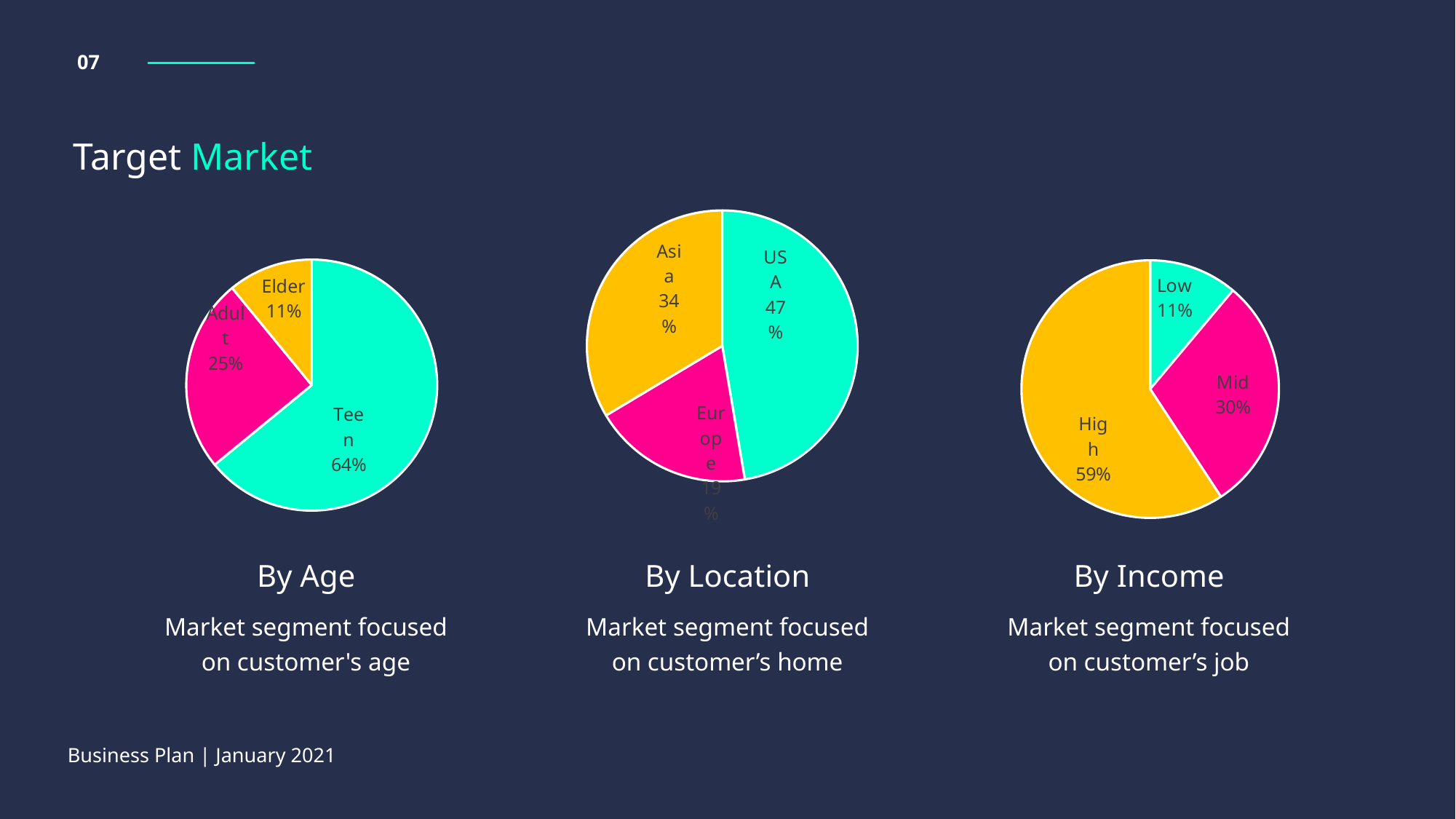
In the By Age pie chart, how many segments are there? 3 In the By Income pie chart, what is the difference between the High and Mid shares? 29% In the By Income pie chart, which is larger, Mid or Low? Mid In the By Age pie chart, what share does Adult have? 25% In the By Location pie chart, what share does USA have? 47% In the By Age pie chart, which segment is the smallest? Elder In the By Location pie chart, what share does Asia have? 34% In the By Location pie chart, which segment is the largest? USA What type of chart is used for the By Income breakdown? Pie chart In the By Location pie chart, what is the difference between the USA and Asia shares? 13% In the By Income pie chart, what share does High have? 59% In the By Age pie chart, what share does Teen have? 64%